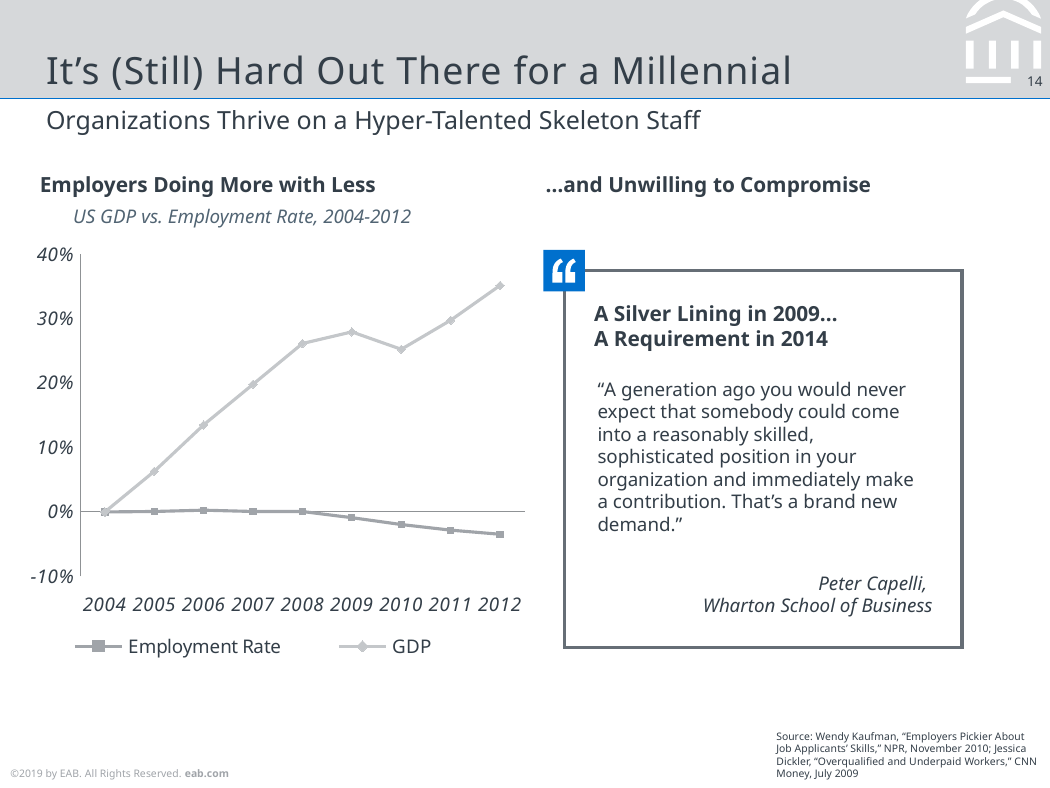
Is the GDP value for 2006 greater or less than 10%? greater What is the subtitle of the chart? US GDP vs. Employment Rate, 2004-2012 In which year is the GDP value highest? 2012 In which year is the Employment Rate value lowest? 2012 What kind of chart is shown on the slide? Line chart Which is larger, the GDP value for 2009 or for 2010? 2009 How many series does the chart's legend list? 2 Is the Employment Rate value for 2012 greater or less than 0%? less Does the Employment Rate line rise or fall from 2008 to 2012? Fall Does the GDP line generally rise or fall from 2004 to 2012? Rise How many years are plotted along the x axis of the chart? 9 Is the GDP value for 2012 greater or less than 30%? greater